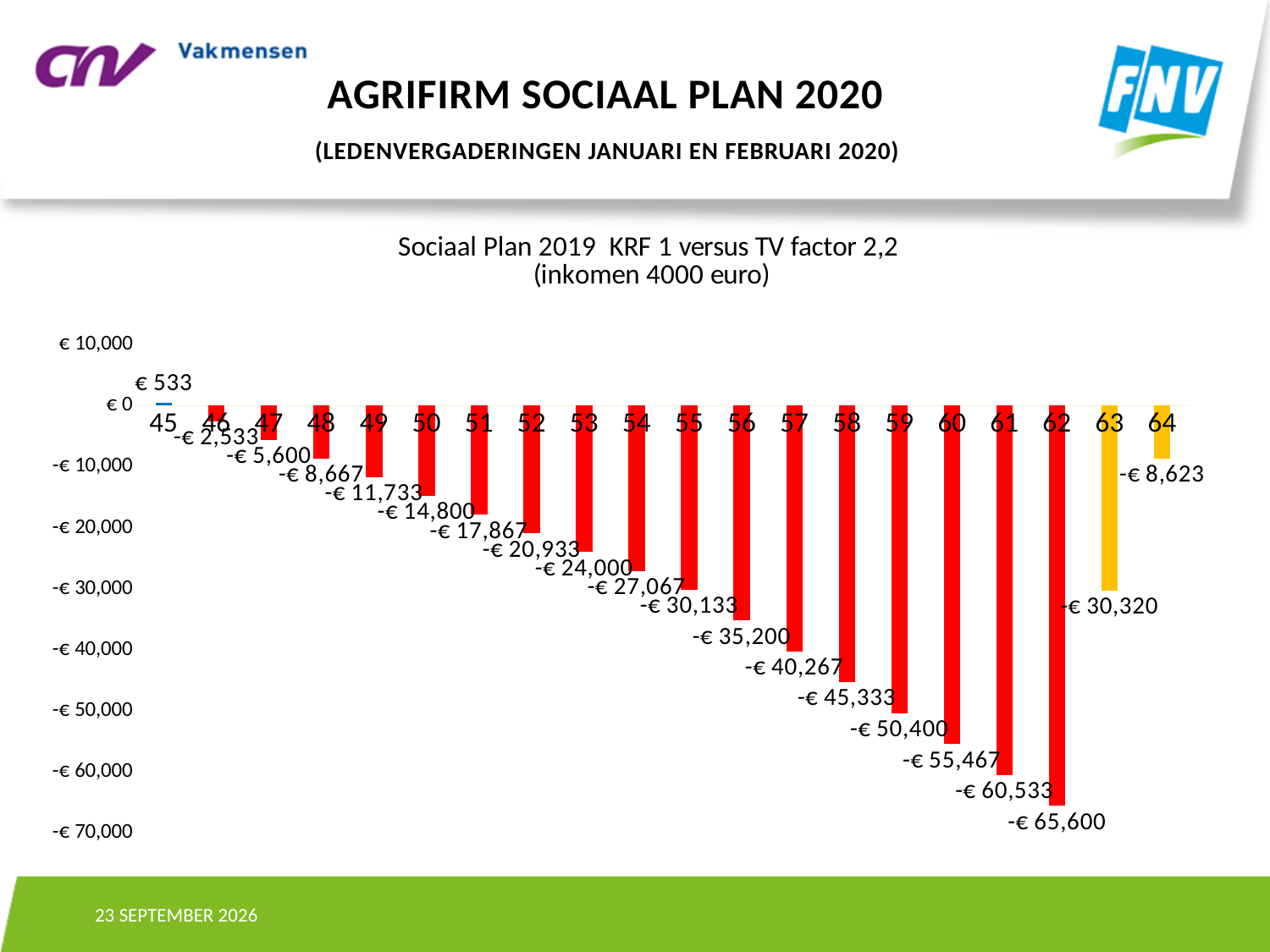
Which category has the highest value? 45 What is the value for category 45? € 533 What is the value for category 56? -€ 35,200 What is the value for category 63? -€ 30,320 Is the value for category 59 greater or less than -€ 40,000? less Do the values rise or fall from category 45 to category 62? fall How many categories are shown on the x axis? 20 What kind of chart is shown? bar chart What is the difference between the values for category 64 and category 47? € 3,023 Which has the larger value, category 55 or category 63? 55 What is the value for category 62? -€ 65,600 Which category has the lowest value? 62